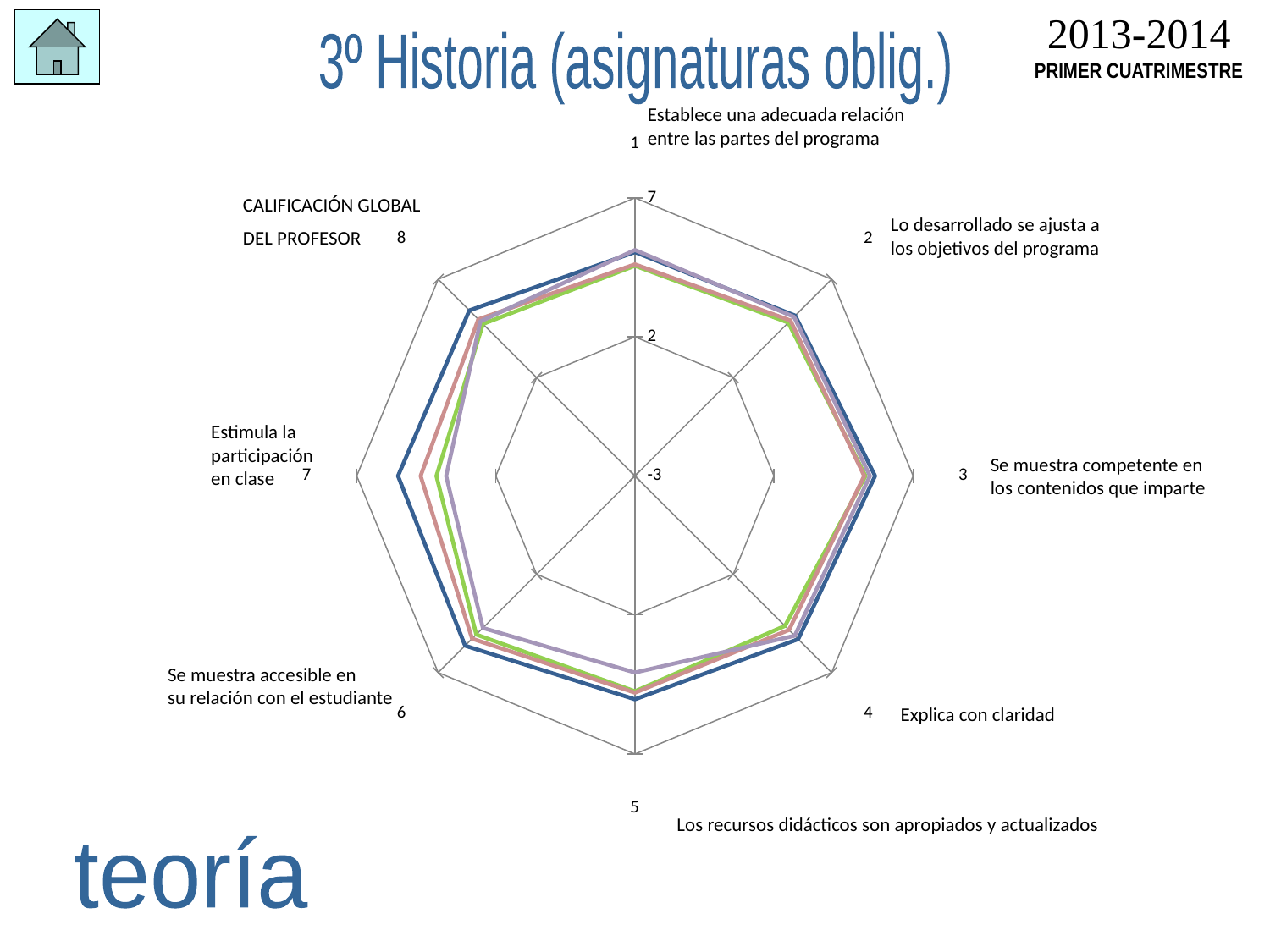
What is the title of the chart on the slide? 3º Historia (asignaturas oblig.) How many data series (lines) are plotted on the radar chart? 4 What is the highest tick value shown on the radar chart's axis? 7 For 'Estimula la participación en clase', is the dark blue line's value larger or smaller than the purple line's value? larger Is the value for 'Se muestra competente en los contenidos que imparte' greater or less than 2 for all plotted series? greater Is the value for 'Estimula la participación en clase' greater or less than 2 for all plotted series? greater Which category label is shown at axis number 3 of the radar chart? Se muestra competente en los contenidos que imparte Is the value for 'Establece una adecuada relación entre las partes del programa' greater or less than 7 for all plotted series? less For 'Se muestra accesible en su relación con el estudiante', is the dark blue line's value larger or smaller than the purple line's value? larger What kind of chart is shown on the slide? radar chart How many categories (axes) does the radar chart have? 8